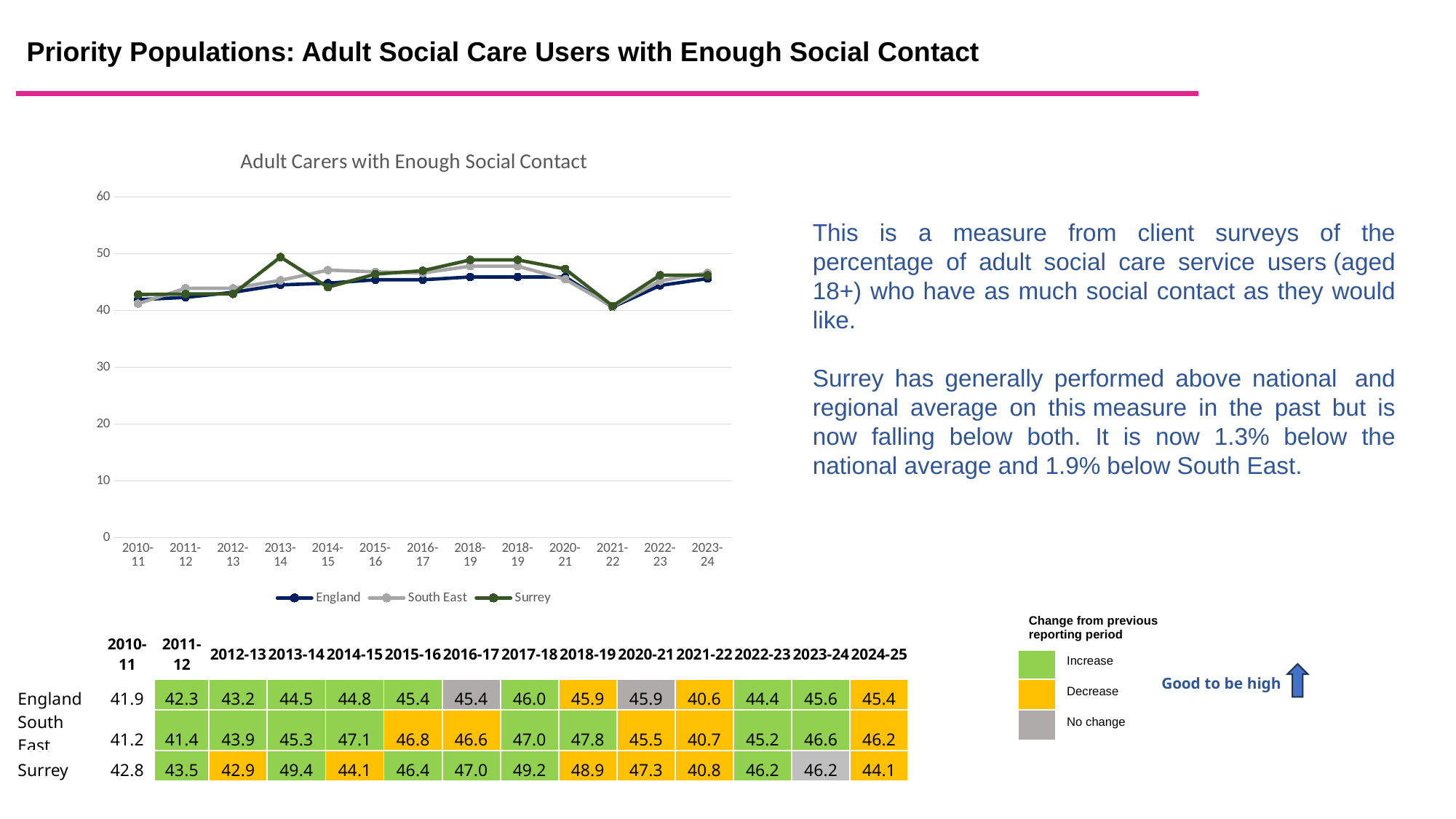
In the table, what is the value for England in 2024-25? 45.4 In the table, which is larger in 2024-25, the England value or the Surrey value? England In the table, what is the difference between the South East and Surrey values in 2024-25? 2.1 Which series are listed in the chart's legend? England, South East, Surrey What is the title of the chart? Adult Carers with Enough Social Contact In the chart, is the value for Surrey in 2013-14 greater or less than 40? greater In the table, which reporting period has the highest value for Surrey? 2013-14 In the table, what is the value for South East in 2018-19? 47.8 How many series does the chart's legend list? 3 In the chart, is the value for England in 2021-22 greater or less than 50? less What kind of chart is shown on the slide? Line chart In the table, which reporting period has the lowest value for England? 2021-22